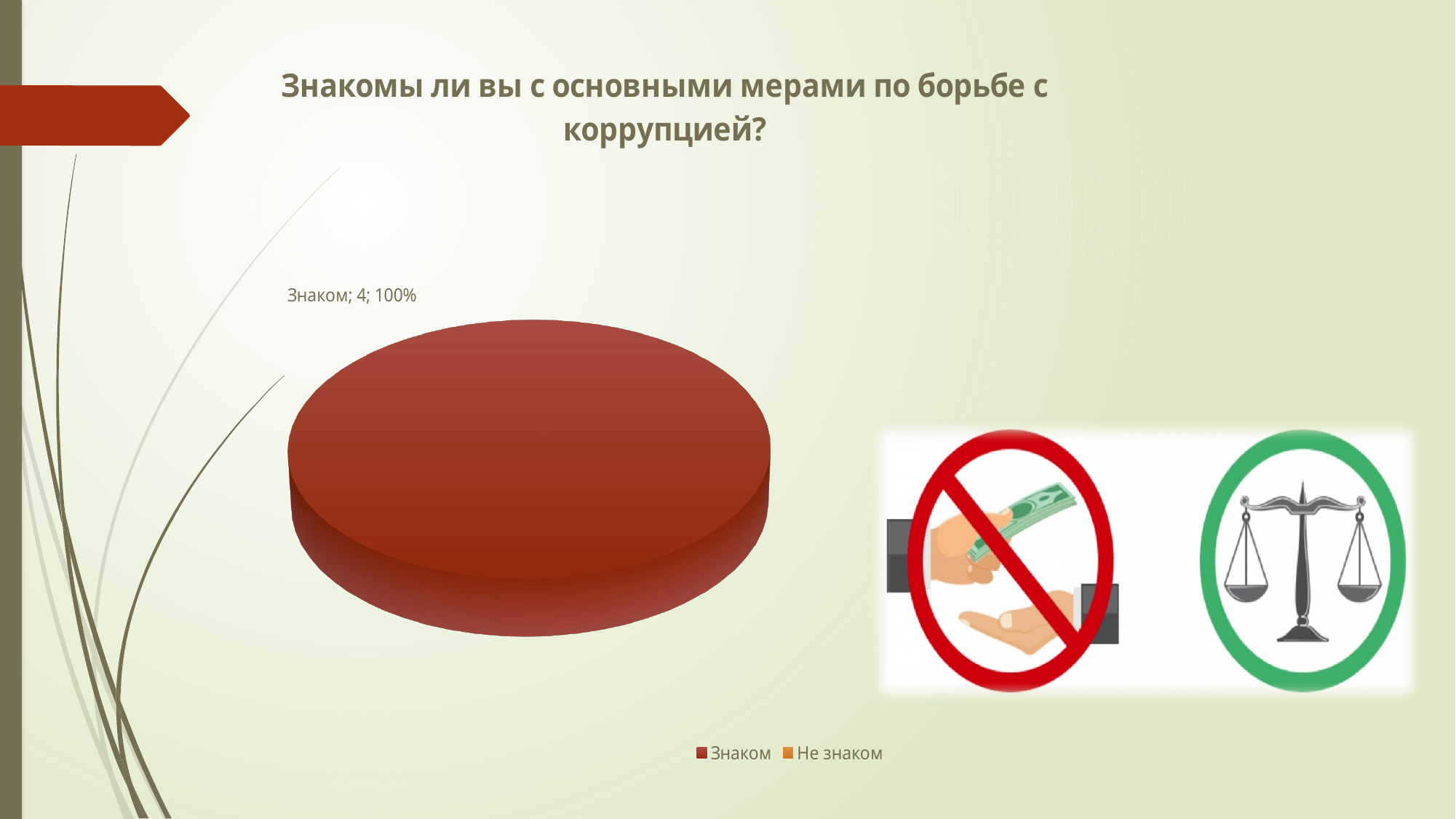
What percentage share does the "Знаком" slice have? 100% What are the two legend entries? Знаком, Не знаком How many slices are visible in the pie? 1 How many entries does the legend list? 2 Which category makes up the entire pie? Знаком What is the title of the chart? Знакомы ли вы с основными мерами по борьбе с коррупцией? Is the share of the "Знаком" slice greater or less than 50%? greater What is the value shown for the "Знаком" slice? 4 What kind of chart is shown on the slide? pie chart